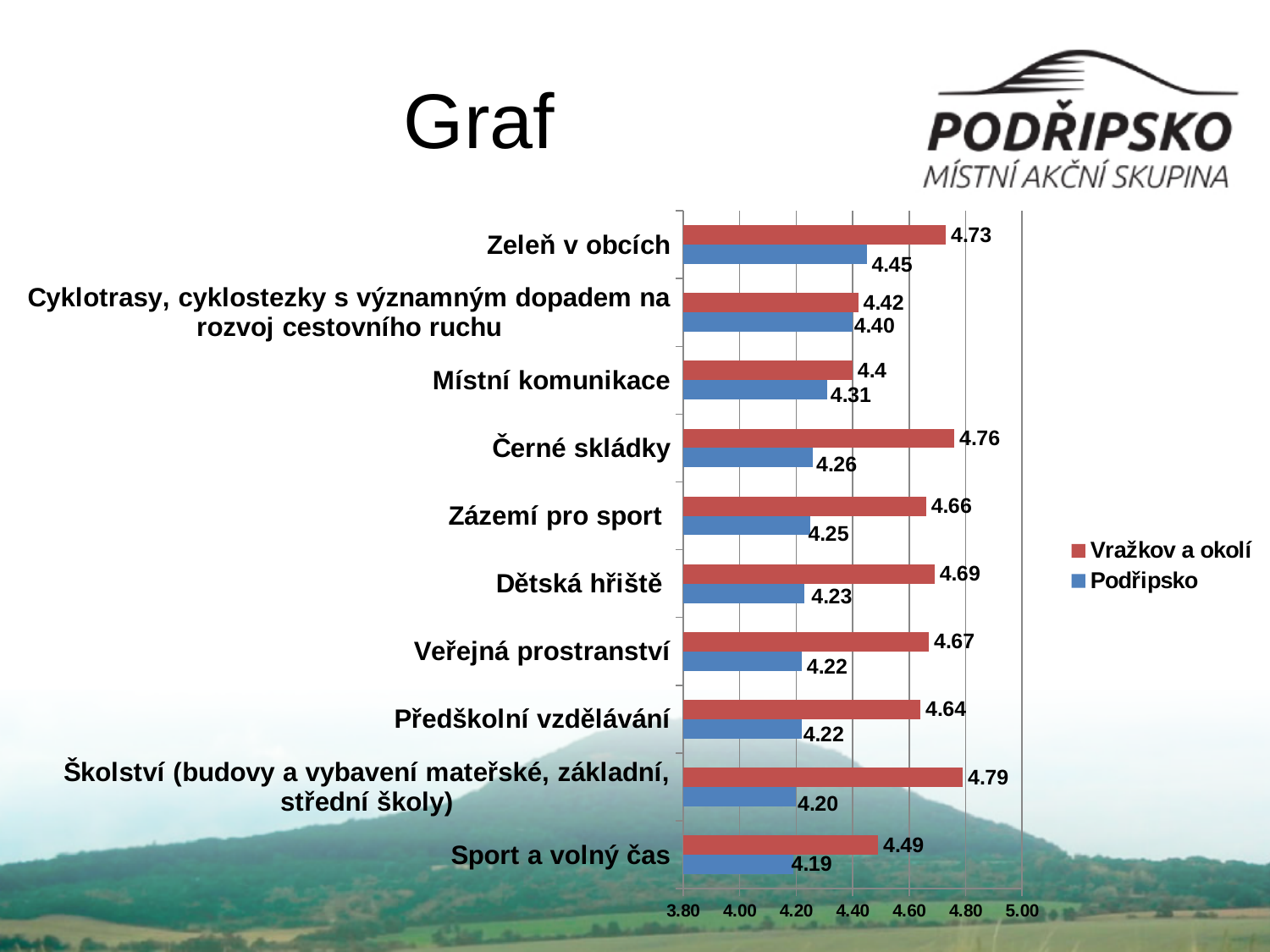
Is the Podřipsko value for Místní komunikace greater or less than 4.20? greater What kind of chart is shown on the slide? Bar chart What is the difference between the Vražkov a okolí and Podřipsko values for Černé skládky? 0.50 Which category has the lowest value for Podřipsko? Sport a volný čas How many series does the legend list? 2 Which is larger for Dětská hřiště: the Vražkov a okolí value or the Podřipsko value? Vražkov a okolí What is the value for Podřipsko for Sport a volný čas? 4.19 What is the value for Vražkov a okolí for Černé skládky? 4.76 Which category has the highest value for Podřipsko? Zeleň v obcích How many categories are shown in the chart? 10 Which category has the highest value for Vražkov a okolí? Školství (budovy a vybavení mateřské, základní, střední školy) What is the value for Podřipsko for Zeleň v obcích? 4.45